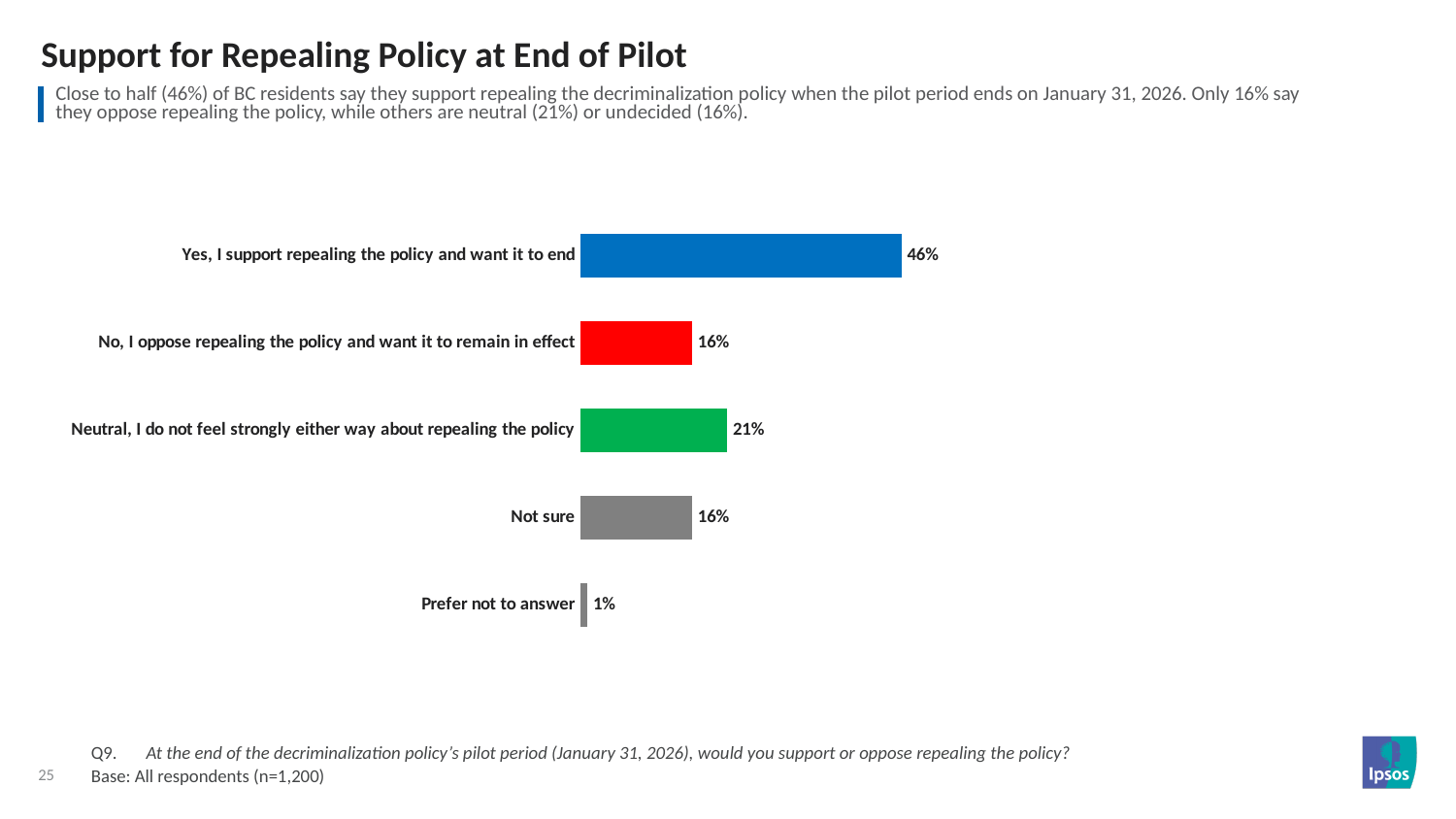
What percentage of respondents were neutral about repealing the policy? 21% Which is larger: the share who are neutral about repealing the policy or the share who oppose repealing it? Neutral, I do not feel strongly either way about repealing the policy Which response category has the highest value? Yes, I support repealing the policy and want it to end What percentage of respondents answered "Prefer not to answer"? 1% How many response categories are shown in the chart? 5 What percentage of respondents said "Yes, I support repealing the policy and want it to end"? 46% What colour is the bar for "No, I oppose repealing the policy and want it to remain in effect"? Red What type of chart is shown on the slide? Bar chart Which response category has the lowest value? Prefer not to answer What is the difference in percentage points between those who support repealing the policy and those who oppose repealing it? 30 What percentage of respondents said "No, I oppose repealing the policy and want it to remain in effect"? 16% What is the difference in percentage points between the "Neutral" response and the "Not sure" response? 5